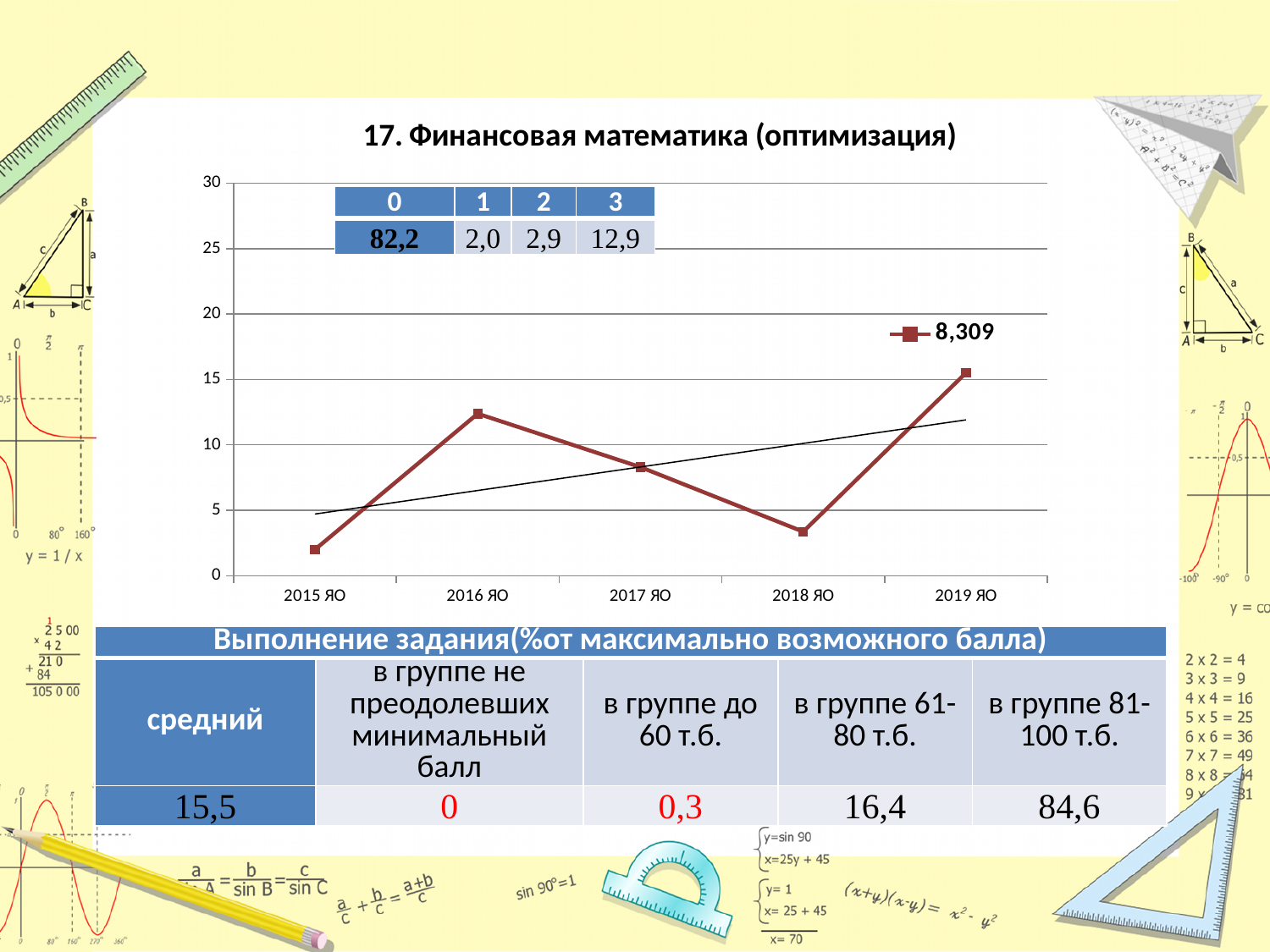
Which year has the highest value on the chart? 2019 ЯО What is the title of the chart? 17. Финансовая математика (оптимизация) Which is larger, the value for 2018 ЯО or the value for 2019 ЯО? 2019 ЯО What kind of chart is shown on the slide? line chart Is the value for 2018 ЯО greater or less than 5? less Which is larger, the value for 2016 ЯО or the value for 2017 ЯО? 2016 ЯО How many points are plotted along the x axis of the chart? 5 Is the value for 2016 ЯО greater or less than 10? greater What is the legend entry shown for the plotted series? 8,309 Which year has the lowest value on the chart? 2015 ЯО How many series does the chart legend list? 1 Does the value rise or fall from 2018 ЯО to 2019 ЯО? rise